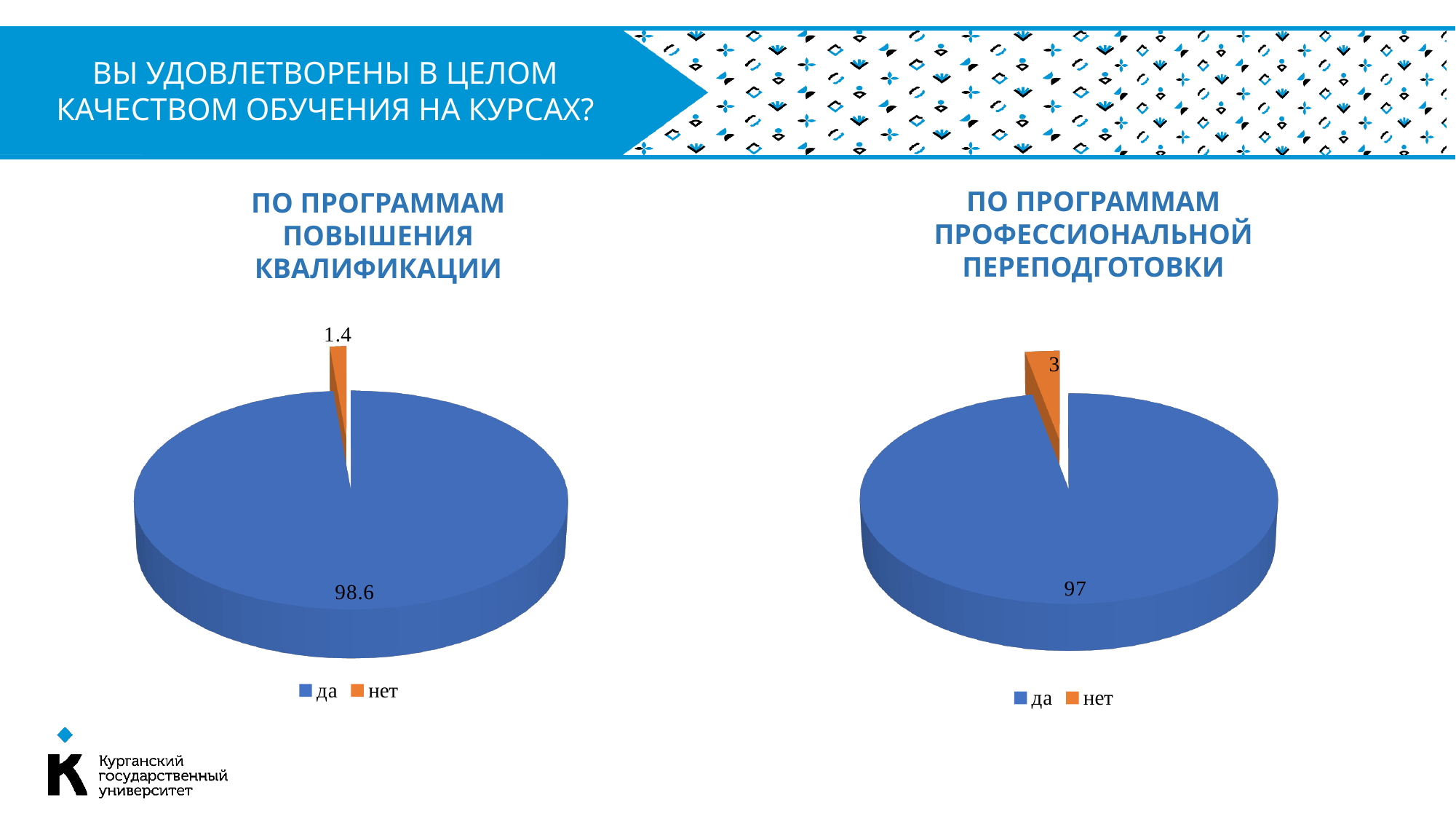
In the left pie chart, what is the difference between the values for "да" and "нет"? 97.2 In the left pie chart, what colour is the "нет" slice? orange Which chart has the larger value for "нет": the left chart or the right chart? the right chart In the left pie chart (ПО ПРОГРАММАМ ПОВЫШЕНИЯ КВАЛИФИКАЦИИ), what is the value for "да"? 98.6 In the right pie chart (ПО ПРОГРАММАМ ПРОФЕССИОНАЛЬНОЙ ПЕРЕПОДГОТОВКИ), what is the value for "нет"? 3 In the left pie chart, which category has the largest slice? да What type of chart is used on the left side of the slide? pie chart In the left pie chart (ПО ПРОГРАММАМ ПОВЫШЕНИЯ КВАЛИФИКАЦИИ), what is the value for "нет"? 1.4 In the right pie chart, which category has the smallest slice? нет In the right pie chart, what is the difference between the values for "да" and "нет"? 94 How many series does the legend of the right pie chart list? 2 In the right pie chart (ПО ПРОГРАММАМ ПРОФЕССИОНАЛЬНОЙ ПЕРЕПОДГОТОВКИ), what is the value for "да"? 97